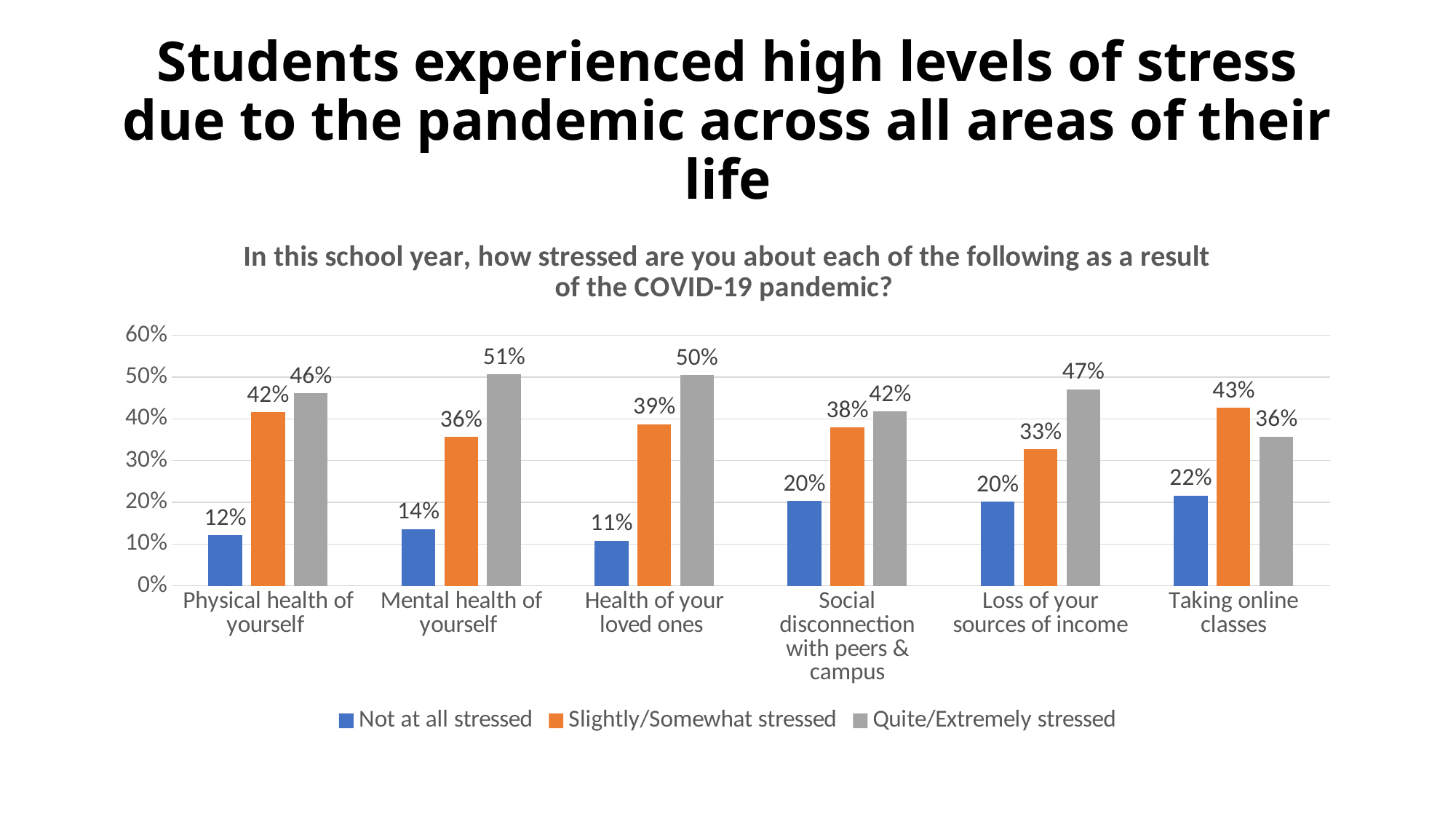
Which colour represents the Not at all stressed series? Blue Which category has the highest Quite/Extremely stressed value? Mental health of yourself How many series does the legend list? 3 For Taking online classes, which is larger: the Slightly/Somewhat stressed value or the Quite/Extremely stressed value? Slightly/Somewhat stressed How many categories are shown on the x axis? 6 Is the Quite/Extremely stressed value for Physical health of yourself greater or less than 40%? greater What percentage of students were Quite/Extremely stressed about Mental health of yourself? 51% What percentage of students were Slightly/Somewhat stressed about Taking online classes? 43% What percentage of students were Not at all stressed about Health of your loved ones? 11% Which category has the lowest Not at all stressed value? Health of your loved ones What kind of chart is shown on the slide? Bar chart What is the difference between the Quite/Extremely stressed and Slightly/Somewhat stressed values for Loss of your sources of income? 14%